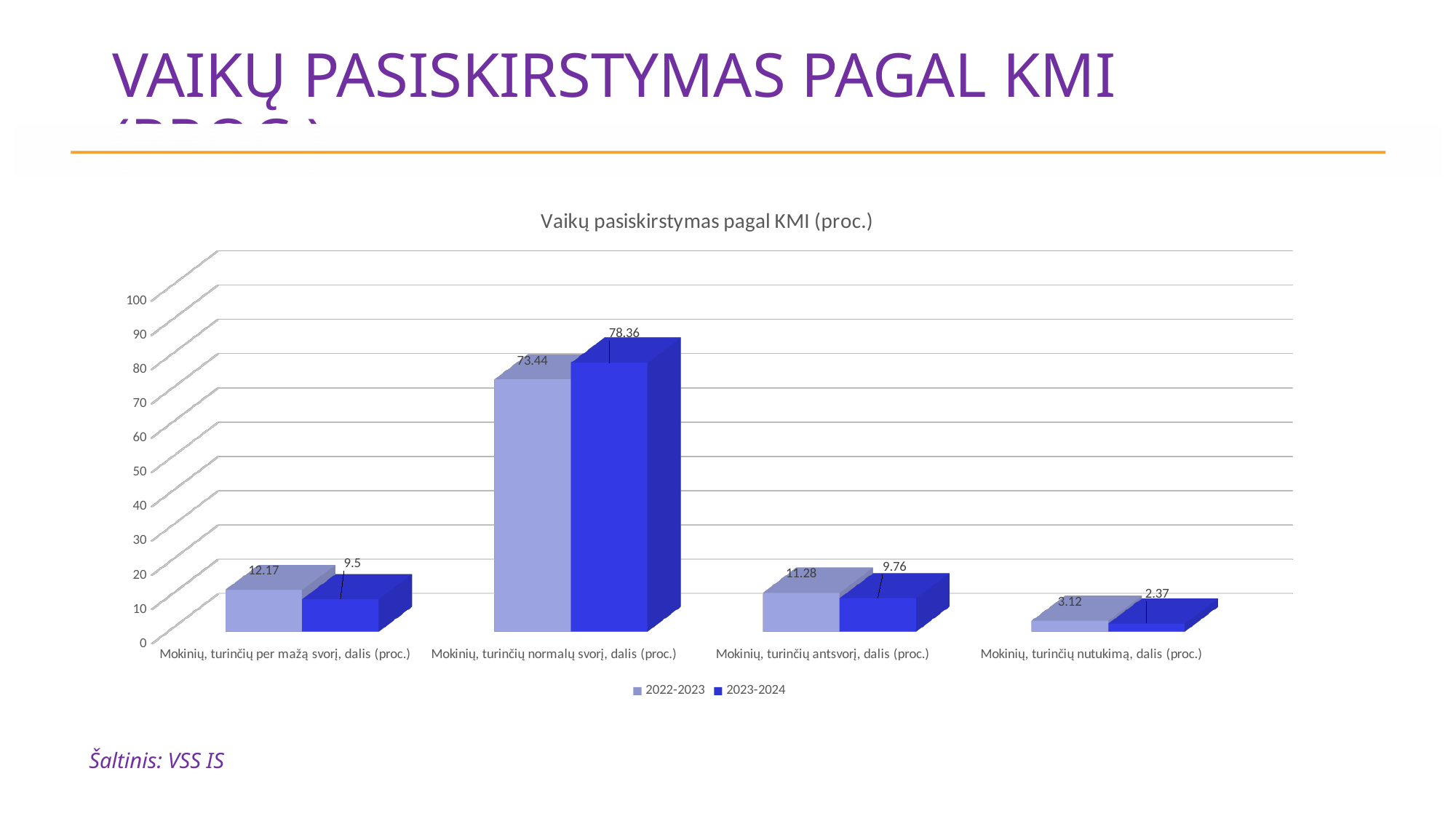
Which category has the highest value in the 2022-2023 series? Mokinių, turinčių normalų svorį, dalis (proc.) How many series does the legend list? 2 What is the value for 'Mokinių, turinčių nutukimą, dalis (proc.)' in the 2023-2024 series? 2.37 Which category has the lowest value in the 2023-2024 series? Mokinių, turinčių nutukimą, dalis (proc.) What is the value for 'Mokinių, turinčių antsvorį, dalis (proc.)' in the 2022-2023 series? 11.28 What kind of chart is shown on the slide? Bar chart How many categories are shown on the x axis? 4 What is the value for 'Mokinių, turinčių per mažą svorį, dalis (proc.)' in the 2022-2023 series? 12.17 What is the title of the chart? Vaikų pasiskirstymas pagal KMI (proc.) What is the value for 'Mokinių, turinčių normalų svorį, dalis (proc.)' in the 2023-2024 series? 78.36 For 'Mokinių, turinčių antsvorį, dalis (proc.)', which series has the larger value, 2022-2023 or 2023-2024? 2022-2023 What is the difference between the 2023-2024 and 2022-2023 values for 'Mokinių, turinčių normalų svorį, dalis (proc.)'? 4.92